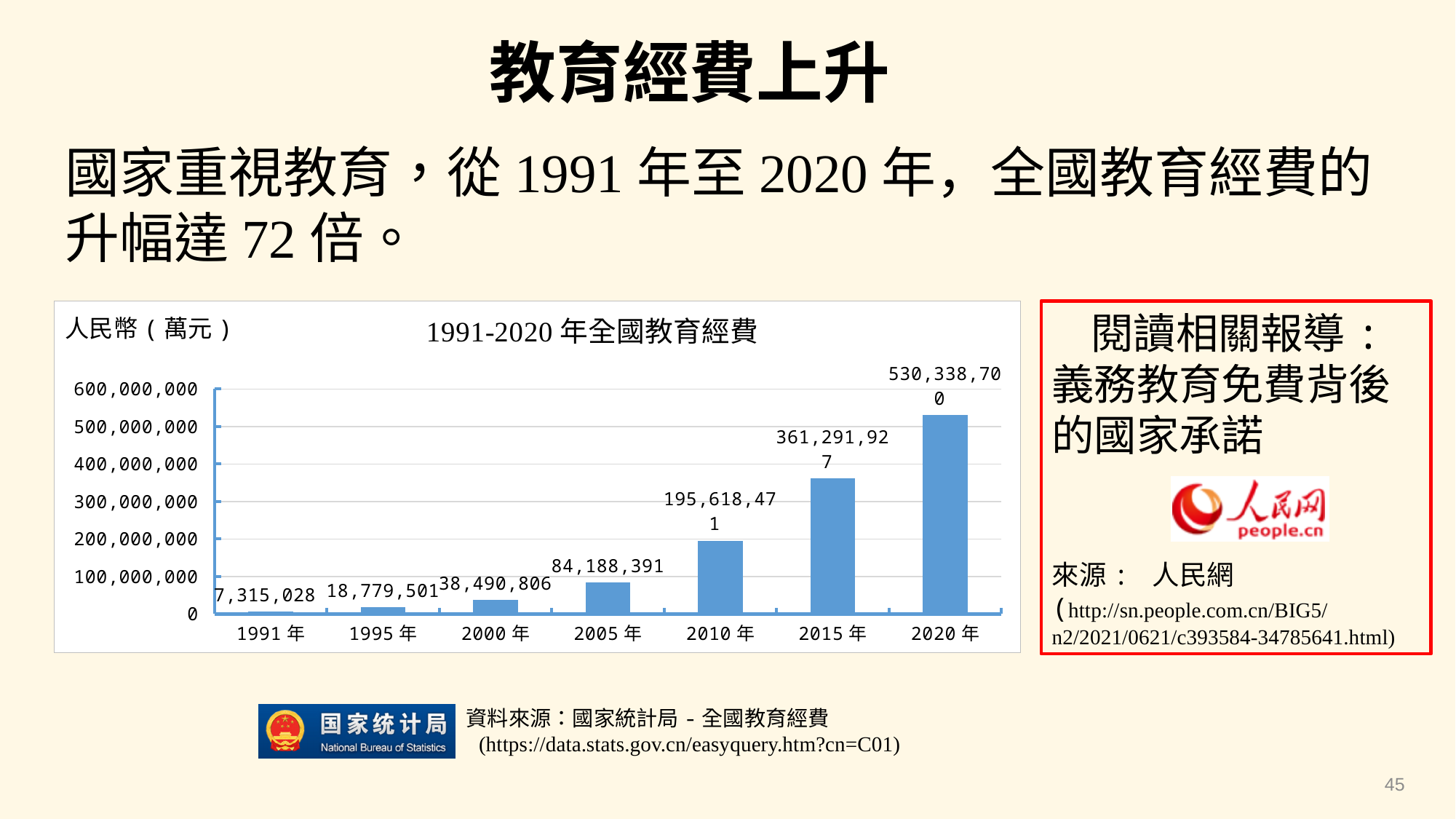
What is the difference between the values for 2020 年 and 2015 年? 169,046,773 How many years are shown on the x axis of the chart? 7 What is the value for 1991 年 in the chart? 7,315,028 What is the difference between the values for 2005 年 and 2000 年? 45,697,585 What is the value for 2010 年 in the chart? 195,618,471 What is the value for 2020 年 in the chart? 530,338,700 Which is larger, the value for 2015 年 or the value for 2010 年? 2015 年 What type of chart is shown on the slide? bar chart Do the values rise or fall from 1991 年 to 2020 年? rise Which year has the highest value in the chart? 2020 年 What is the value for 2005 年 in the chart? 84,188,391 Which year has the lowest value in the chart? 1991 年